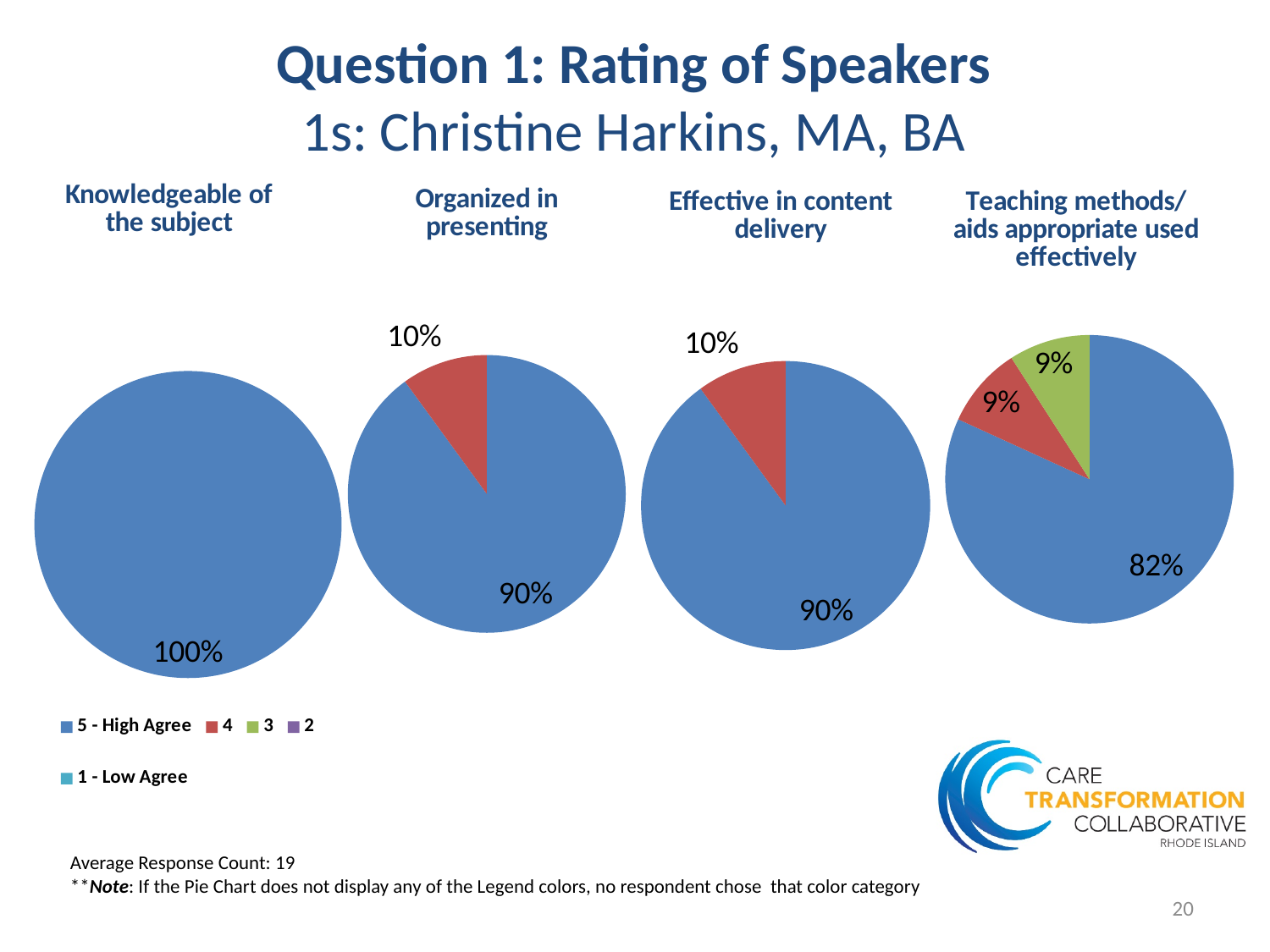
In the 'Teaching methods/aids appropriate used effectively' pie chart, what share of respondents chose '5 - High Agree'? 82% What type of chart is used for 'Organized in presenting'? Pie chart In the 'Teaching methods/aids appropriate used effectively' pie chart, which rating category has the largest slice? 5 - High Agree How many slices are shown in the 'Teaching methods/aids appropriate used effectively' pie chart? 3 In the 'Effective in content delivery' pie chart, what share of respondents chose '5 - High Agree'? 90% In the 'Teaching methods/aids appropriate used effectively' pie chart, what share of respondents chose '3'? 9% In the 'Effective in content delivery' pie chart, which is larger: the '5 - High Agree' slice or the '4' slice? 5 - High Agree How many rating categories does the legend list? 5 In the 'Teaching methods/aids appropriate used effectively' pie chart, what is the difference between the '5 - High Agree' slice and the '4' slice? 73%